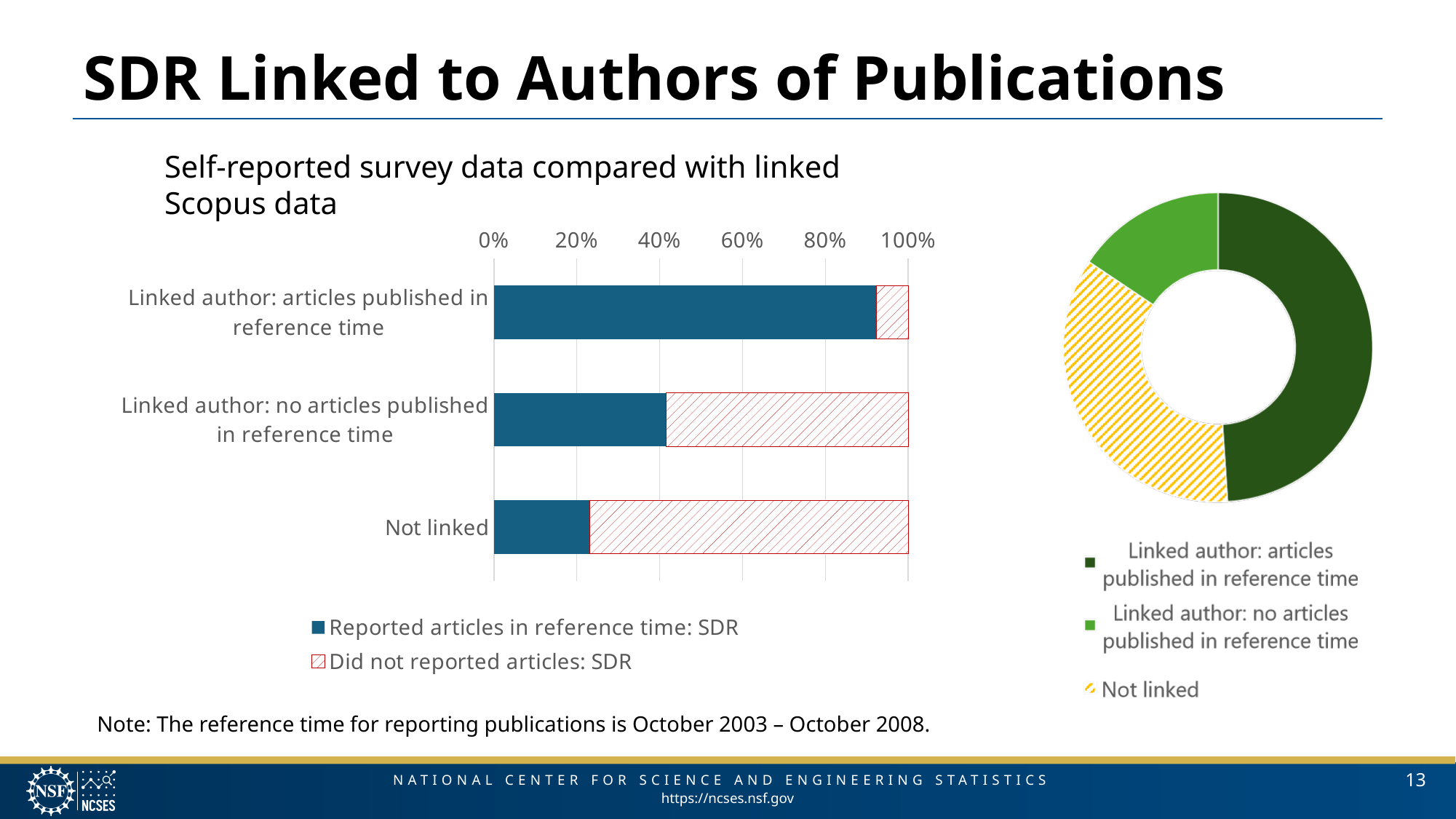
What kind of chart is the chart on the left of the slide? bar chart In the bar chart on the left, how many categories are shown on the vertical axis? 3 In the bar chart on the left, which category has the smallest share of 'Reported articles in reference time: SDR'? Not linked In the bar chart on the left, how many series does the legend list? 2 In the bar chart on the left, is the 'Reported articles in reference time: SDR' share for 'Linked author: no articles published in reference time' greater or less than 60%? less In the bar chart on the left, is the 'Reported articles in reference time: SDR' share for 'Not linked' greater or less than 40%? less In the donut chart on the right, which slice is the largest? Linked author: articles published in reference time In the donut chart on the right, how many slices does the legend list? 3 What kind of chart is the chart on the right of the slide? donut chart In the bar chart on the left, is the 'Reported articles in reference time: SDR' share for 'Linked author: articles published in reference time' greater or less than 80%? greater In the bar chart on the left, which category has the largest share of 'Reported articles in reference time: SDR'? Linked author: articles published in reference time In the donut chart on the right, which slice is the smallest? Linked author: no articles published in reference time